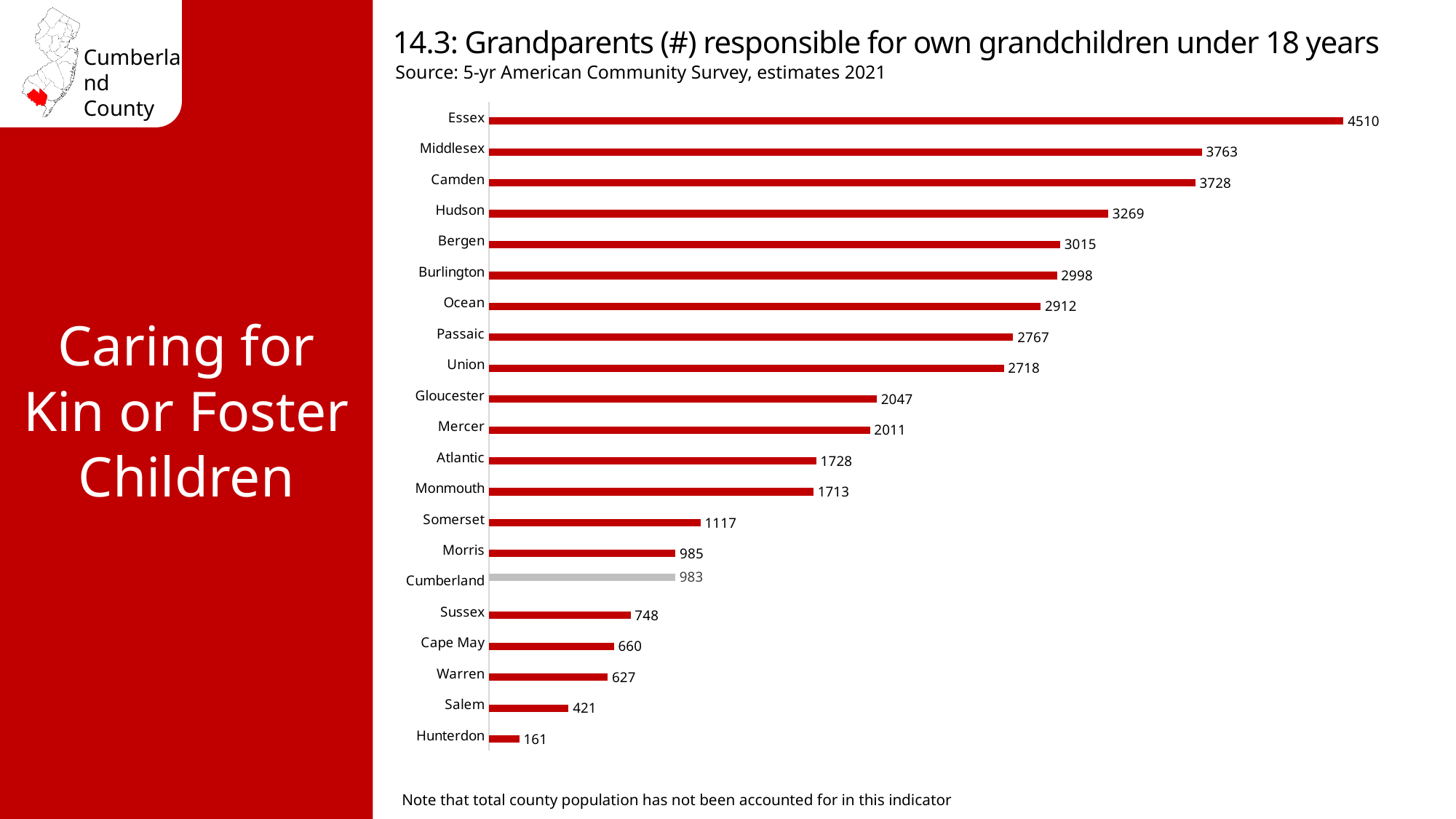
Which county has the lowest value? Hunterdon What is the difference between the values for Essex and Middlesex? 747 Which is larger, the value for Hudson or the value for Bergen? Hudson Which county's bar is shown in grey rather than red? Cumberland What is the difference between the values for Cumberland and Salem? 562 Which county has the highest value? Essex What is the value for Cumberland? 983 What is the value for Essex? 4510 What is the value for Gloucester? 2047 Which is larger, the value for Sussex or the value for Warren? Sussex What kind of chart is shown on the slide? Bar chart How many counties are shown in the chart? 21